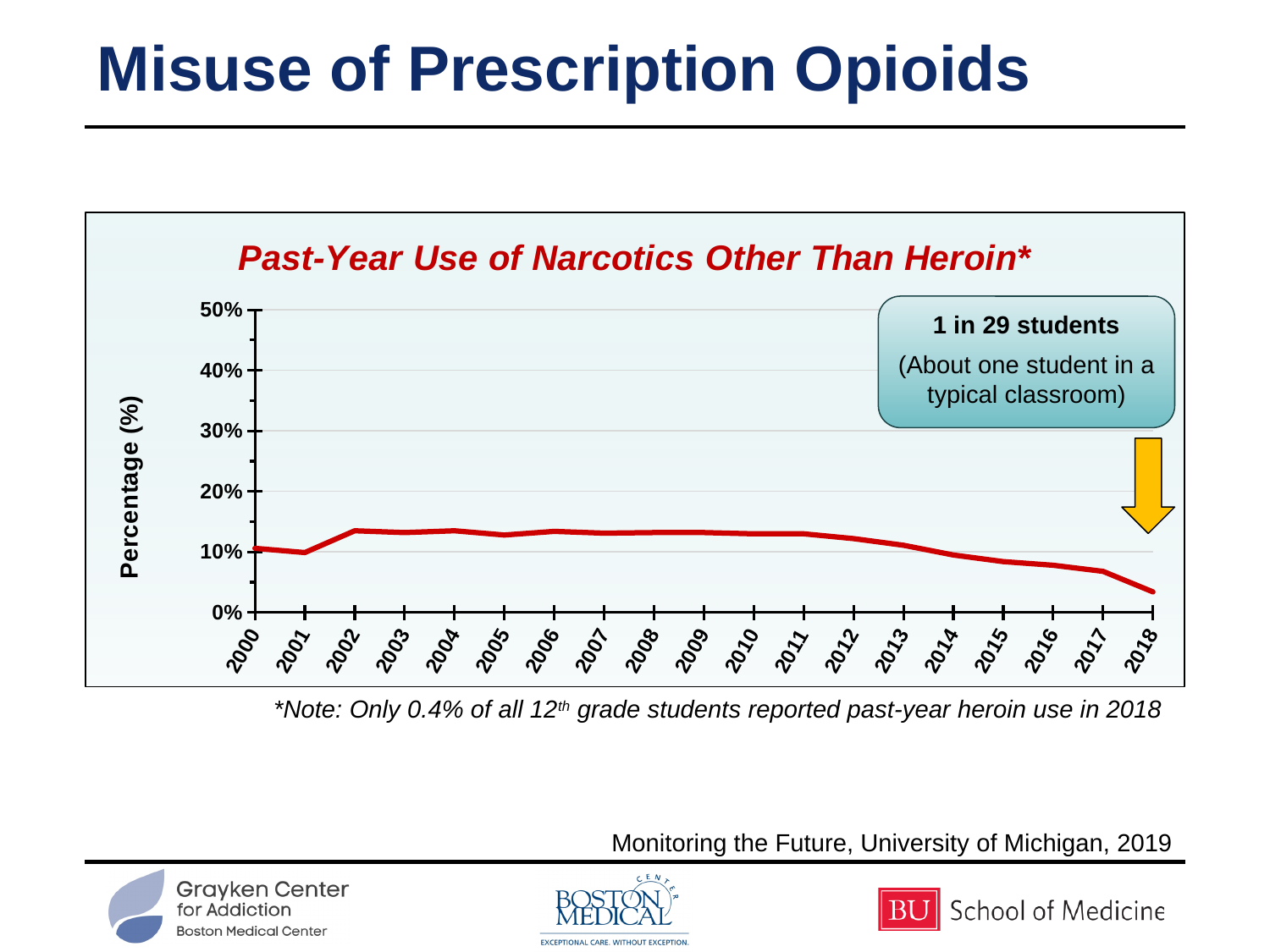
Is the value for 2017 greater or less than 10%? less Which year has the larger value, 2002 or 2018? 2002 What is the label on the vertical axis of the chart? Percentage (%) Which year has the lowest value on the chart? 2018 Do the values rise or fall from 2011 to 2018? Fall Is the value for 2009 greater or less than 20%? less What is the title of the chart? Past-Year Use of Narcotics Other Than Heroin* Is the value for 2018 greater or less than 10%? less Which year has the larger value, 2001 or 2002? 2002 What kind of chart is shown on the slide? Line chart How many years are plotted along the x axis of the chart? 19